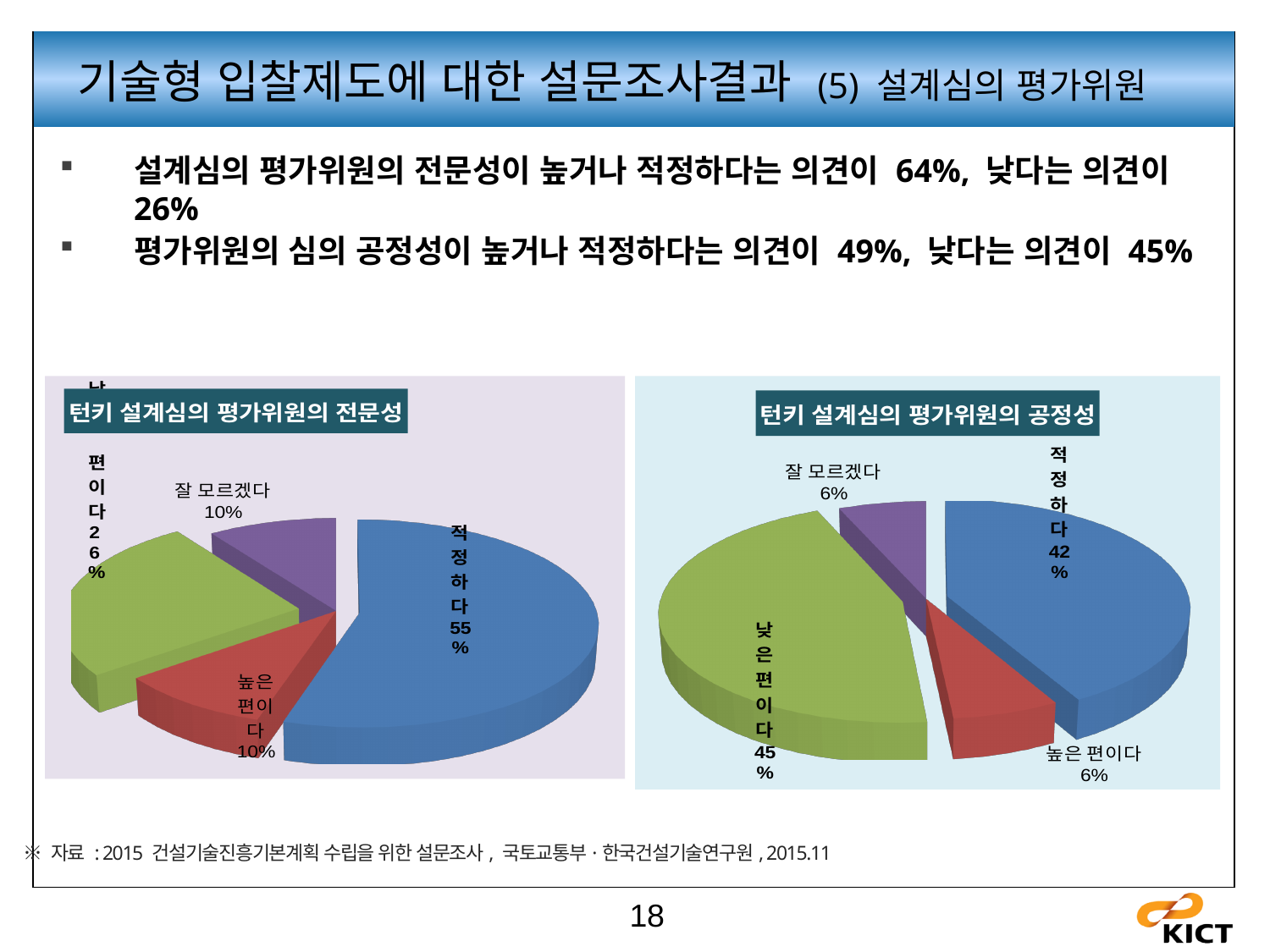
What type of chart is used in the '턴키 설계심의 평가위원의 전문성' chart? pie chart Which chart on the slide has the larger 적정하다 share, the 전문성 chart on the left or the 공정성 chart on the right? the 전문성 chart on the left In the '턴키 설계심의 평가위원의 공정성' chart, what is the combined share of 높은 편이다 and 잘 모르겠다? 12% In the '턴키 설계심의 평가위원의 전문성' chart, what share is labelled for 높은 편이다? 10% In the '턴키 설계심의 평가위원의 공정성' chart, what share is labelled for 낮은 편이다? 45% In the '턴키 설계심의 평가위원의 전문성' chart, what share is labelled for 적정하다? 55% In the '턴키 설계심의 평가위원의 공정성' chart, what share is labelled for 잘 모르겠다? 6% In the '턴키 설계심의 평가위원의 공정성' chart, what is the difference between the 낮은 편이다 share and the 적정하다 share? 3% In the '턴키 설계심의 평가위원의 공정성' chart, what share is labelled for 적정하다? 42% In the '턴키 설계심의 평가위원의 전문성' chart, which category has the largest slice? 적정하다 How many slices does the '턴키 설계심의 평가위원의 전문성' pie chart have? 4 In the '턴키 설계심의 평가위원의 전문성' chart, what share is labelled for 잘 모르겠다? 10%